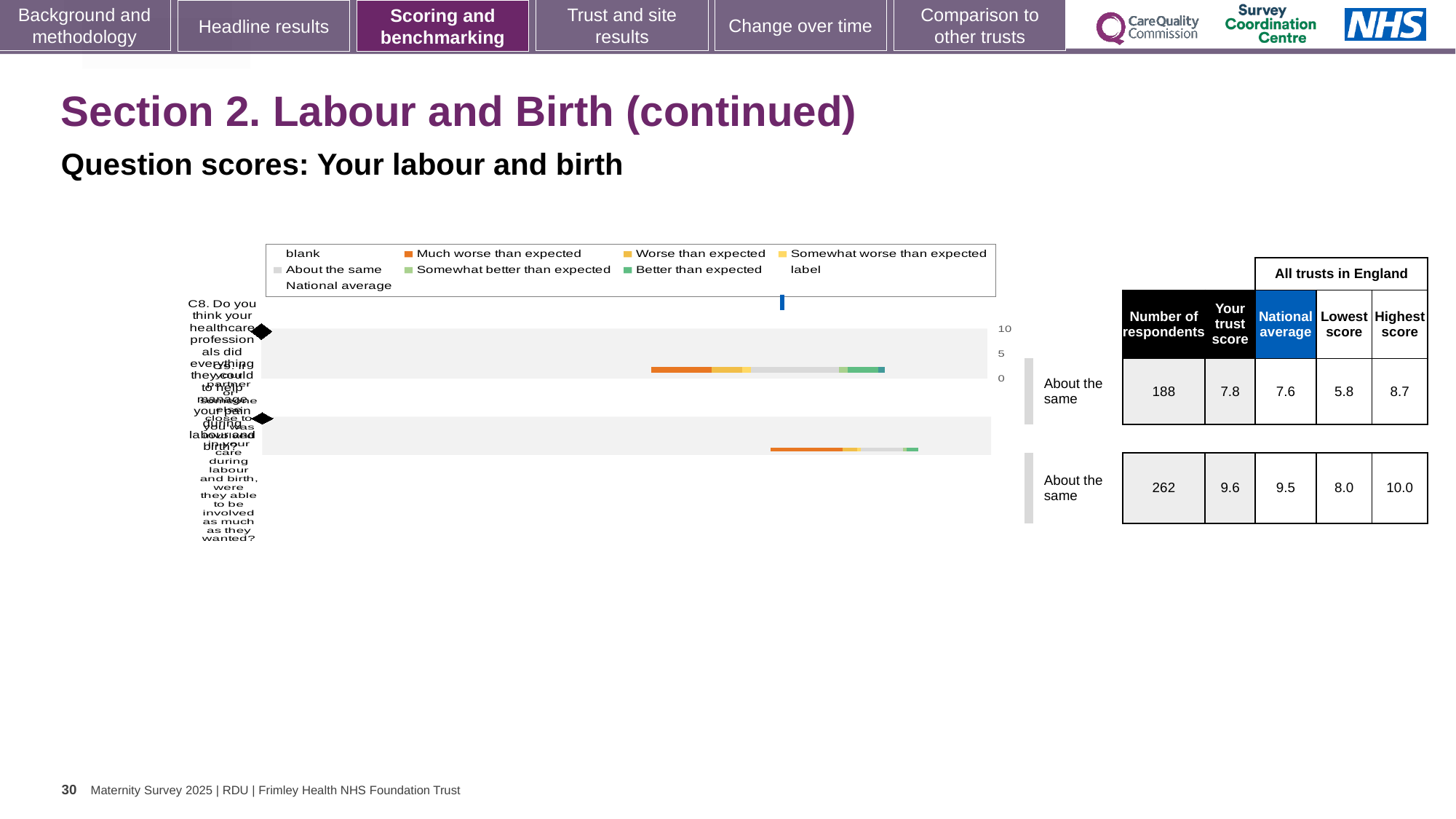
What kind of chart is shown on the slide? bar chart What is the trust score for the first question row in the table? 7.8 What is the number of respondents for the second question row in the table? 262 What is the difference between the highest score and the lowest score for the first question row? 2.9 How many legend entries does the chart's legend list? 9 Which question row has the higher trust score, the first or the second? the second How many question bars are plotted in the chart? 2 What is the highest score among all trusts in England for the second question row? 10.0 What is the number of respondents for the first question row in the table? 188 What is the national average for the first question row in the table? 7.6 Which legend entry is shown in orange? Much worse than expected What benchmark category is given for both question rows? About the same